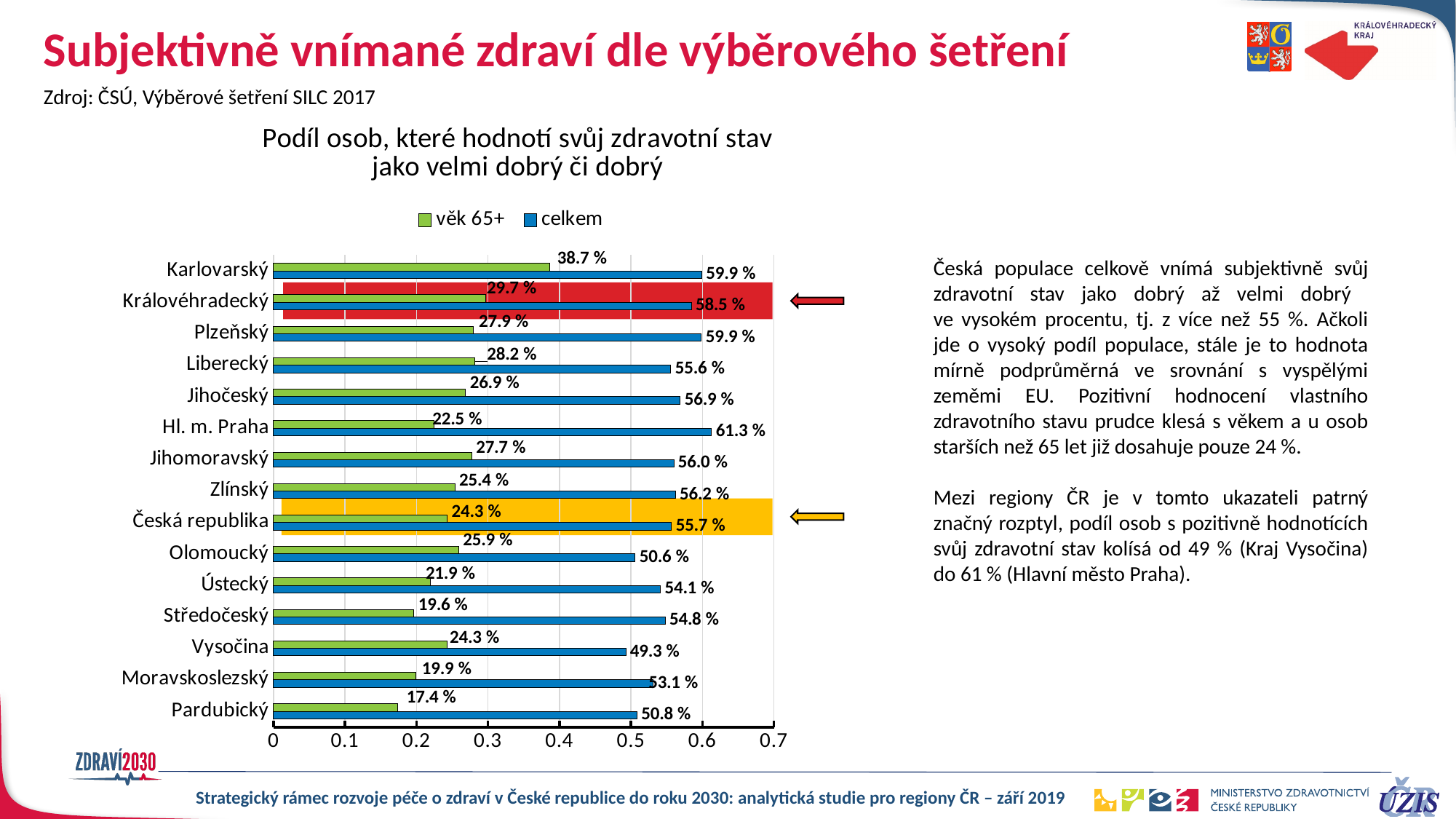
Which series is shown in green in the legend? věk 65+ How many series does the legend list? 2 Which category has the lowest 'věk 65+' value? Pardubický How many categories are shown on the chart? 15 What is the value of the 'celkem' series for Hl. m. Praha? 61.3 % Which category has the lowest 'celkem' value? Vysočina Which category has the highest 'celkem' value? Hl. m. Praha Which is larger: the 'celkem' value for Olomoucký or for Ústecký? Ústecký What is the 'celkem' value for Česká republika? 55.7 % What is the difference between the 'celkem' and 'věk 65+' values for Královéhradecký? 28.8 % What kind of chart is shown on the slide? Bar chart What is the value of the 'věk 65+' series for Karlovarský? 38.7 %